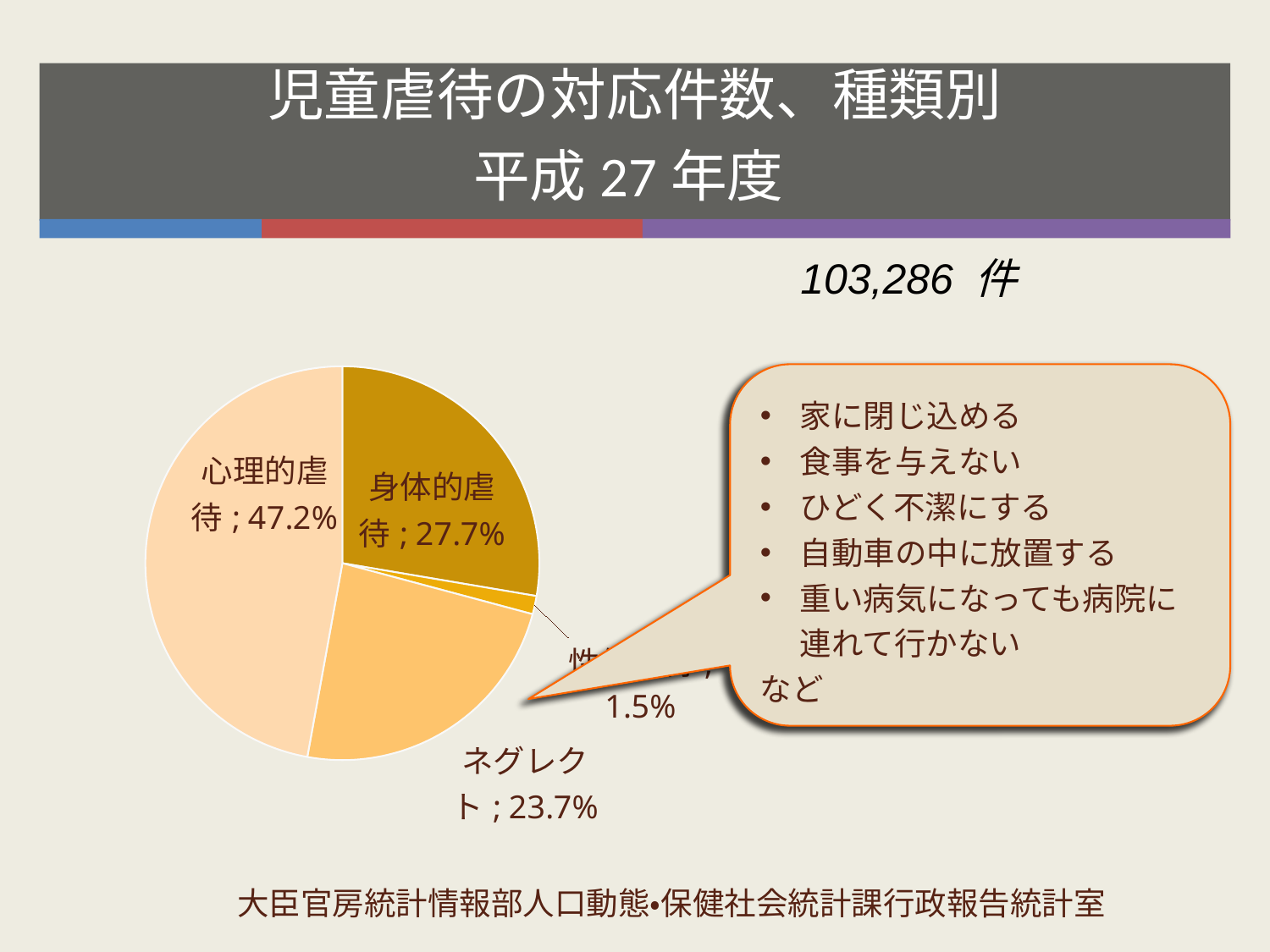
What share of the pie does 心理的虐待 account for? 47.2% What is the percentage shown for the smallest slice of the pie? 1.5% How many slices does the pie chart have? 4 What is the difference in percentage points between 心理的虐待 and 身体的虐待? 19.5 What fiscal year does the chart title refer to? 平成27年度 What kind of chart is shown on the slide? pie chart What share of the pie does 身体的虐待 account for? 27.7% What share of the pie does ネグレクト account for? 23.7% Which category has the largest slice of the pie? 心理的虐待 What is the difference in percentage points between 身体的虐待 and ネグレクト? 4.0 Which is larger, the share for 身体的虐待 or the share for ネグレクト? 身体的虐待 What total number of cases (件) is printed above the chart? 103,286 件